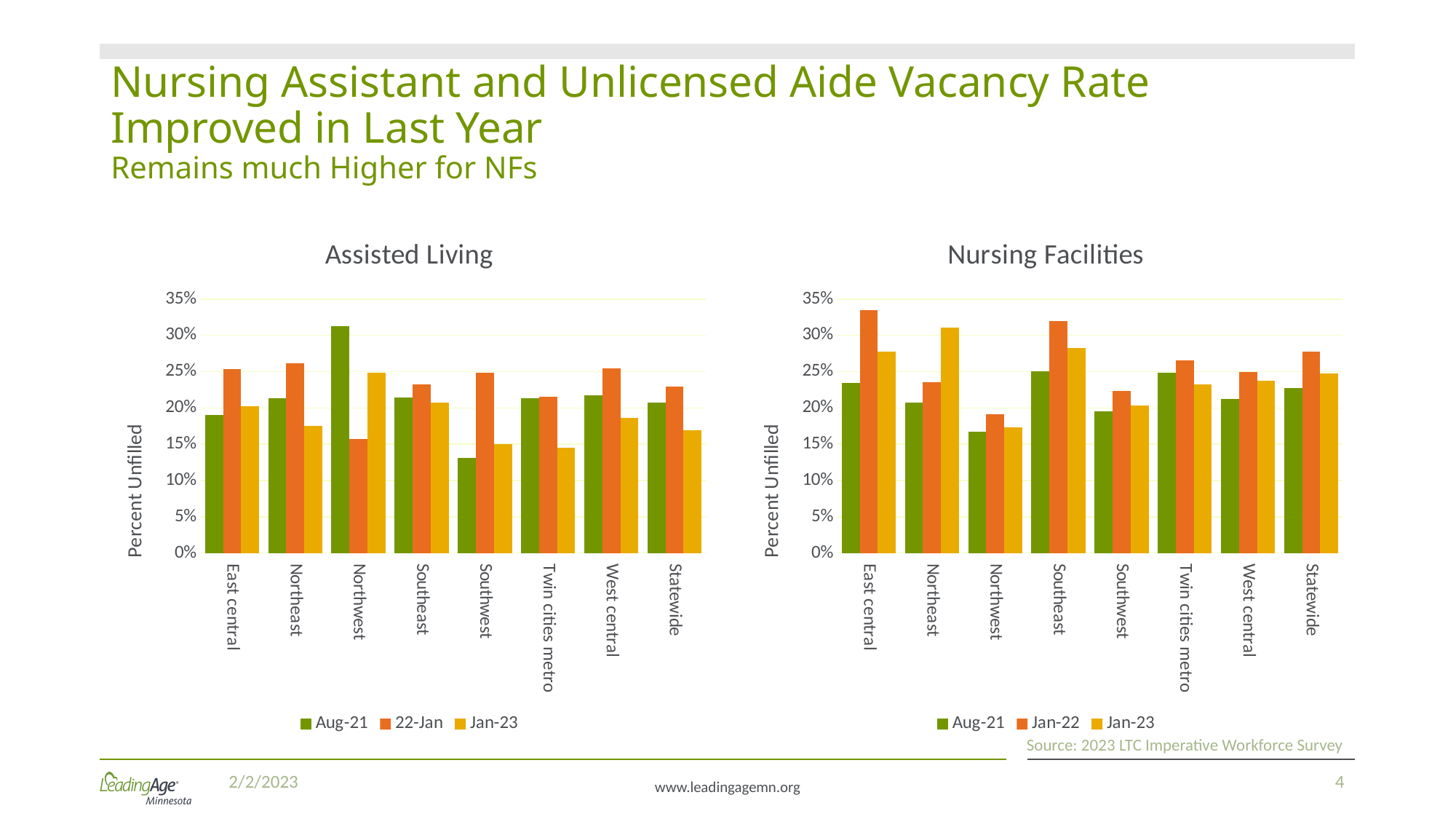
In the Nursing Facilities chart, which region has the lowest Jan-23 bar? Northwest How many regions are shown on the x axis of the Nursing Facilities chart? 8 In the Nursing Facilities chart, is the Jan-23 value for Northeast greater or less than 30%? greater In the Assisted Living chart, for Northwest, which is larger: the Aug-21 value or the 22-Jan value? Aug-21 In the Nursing Facilities chart, for Northeast, which series has the tallest bar? Jan-23 In the Nursing Facilities chart, is the Aug-21 value for Northwest greater or less than 20%? less In the Assisted Living chart, which region has the lowest Aug-21 bar? Southwest In the Assisted Living chart, is the Aug-21 value for Southwest greater or less than 15%? less How many series does the legend of the Assisted Living chart list? 3 What type of chart is the Nursing Facilities chart? bar chart In the Assisted Living chart, which region has the highest Aug-21 bar? Northwest